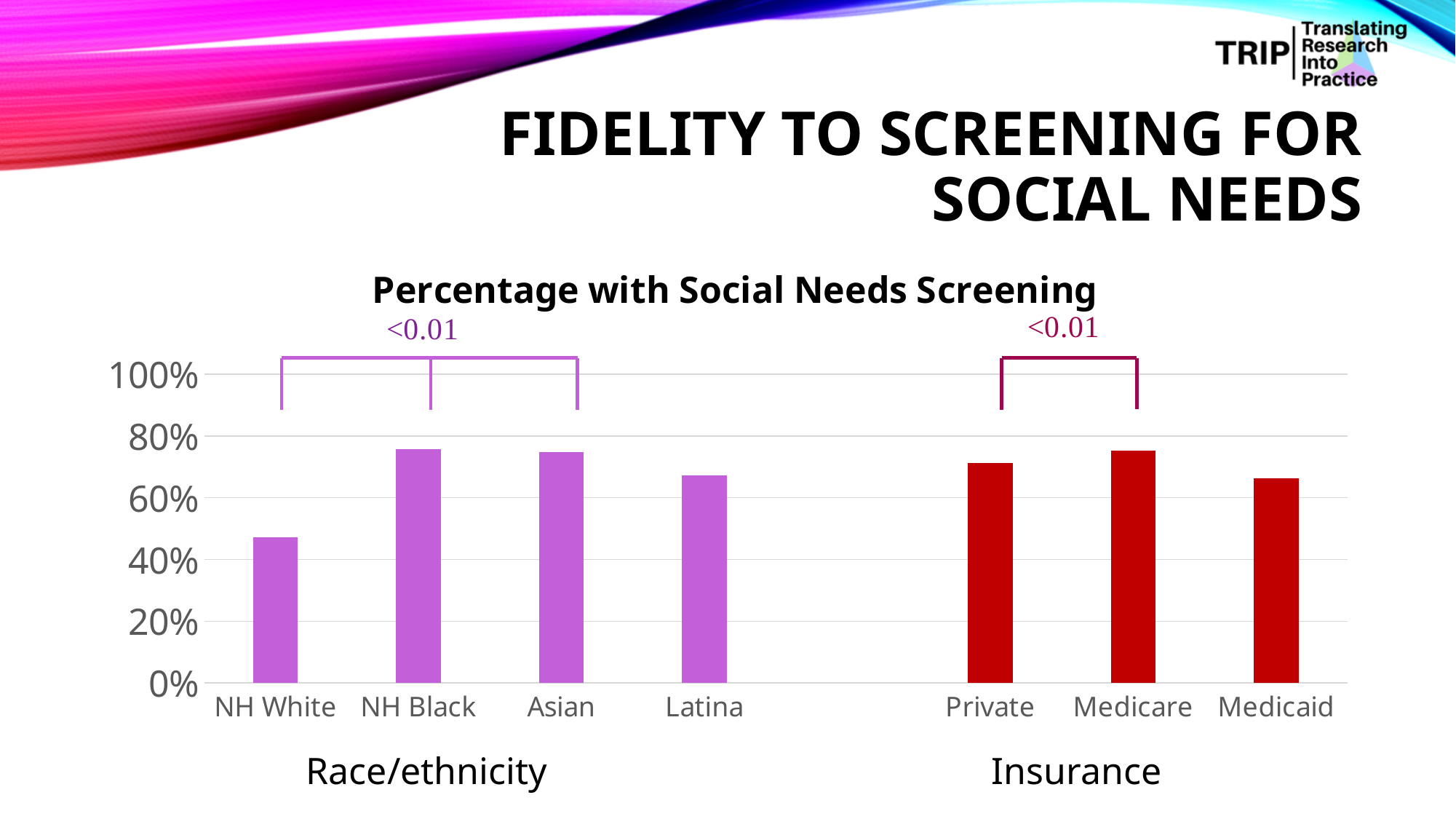
What p-value is shown above the bracket over the Private and Medicare bars? <0.01 How many bars are plotted in the chart? 7 Is the value for NH Black greater or less than 60%? greater What kind of chart is shown on the slide? Bar chart Is the value for Latina greater or less than 60%? greater Which is larger, the value for NH White or the value for NH Black? NH Black Which category has the lowest percentage with social needs screening? NH White Is the value for Asian greater or less than 80%? less What is the title of the chart? Percentage with Social Needs Screening Which is larger, the value for Medicare or the value for Medicaid? Medicare